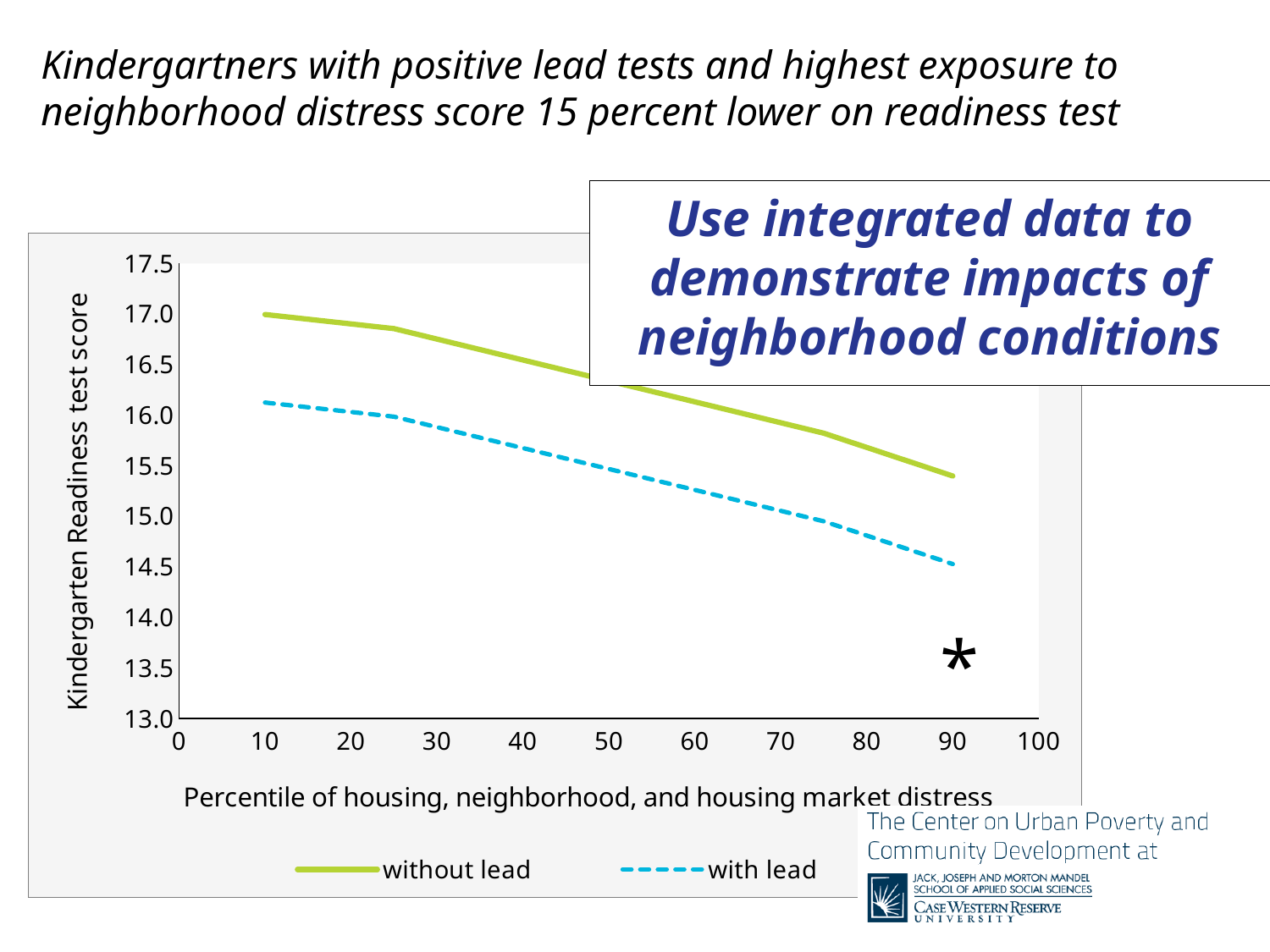
What is the label of the y axis? Kindergarten Readiness test score Is the value for the without lead series at the 10th percentile greater or less than 16.5? greater Which series has the lower Kindergarten Readiness test score across the whole range of percentiles? with lead What are the two series named in the legend? without lead, with lead Is the value for the without lead series at the 90th percentile greater or less than 16.0? less How many series does the legend list? 2 Is the value for the with lead series at the 10th percentile greater or less than 15.5? greater What kind of chart is shown on the slide? line chart Which series is plotted with a dashed line? with lead Do the Kindergarten Readiness test scores rise or fall as the percentile of distress increases along the x axis? fall Which series has the higher Kindergarten Readiness test score at the 50th percentile of distress, without lead or with lead? without lead